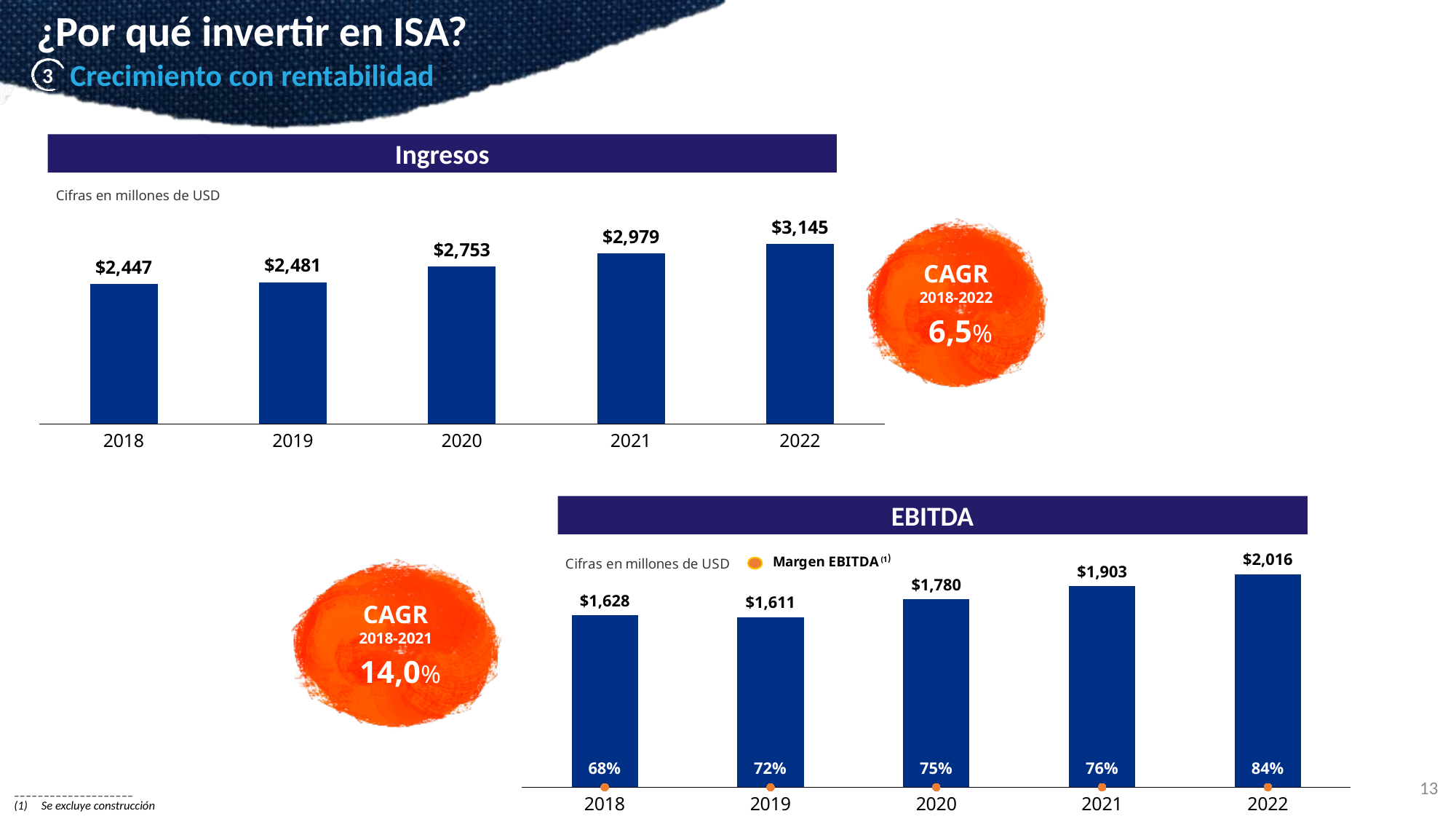
In the EBITDA chart, what is the difference between the 2022 and 2021 EBITDA values? $113 In the Ingresos chart, do the values rise or fall from 2018 to 2022? rise In the Ingresos chart, what is the difference between the 2022 and 2018 values? $698 In the Ingresos chart, how many years are plotted? 5 In the Ingresos chart, what is the value for 2020? $2,753 In the EBITDA chart, what is the Margen EBITDA for 2022? 84% What CAGR for 2018-2022 is shown next to the Ingresos chart? 6,5% In the Ingresos chart, which year has the highest value? 2022 What kind of chart is the Ingresos chart? bar chart In the EBITDA chart, which is larger, the EBITDA value for 2018 or for 2019? 2018 In the EBITDA chart, which year has the lowest EBITDA value? 2019 In the EBITDA chart, what is the EBITDA value for 2021? $1,903